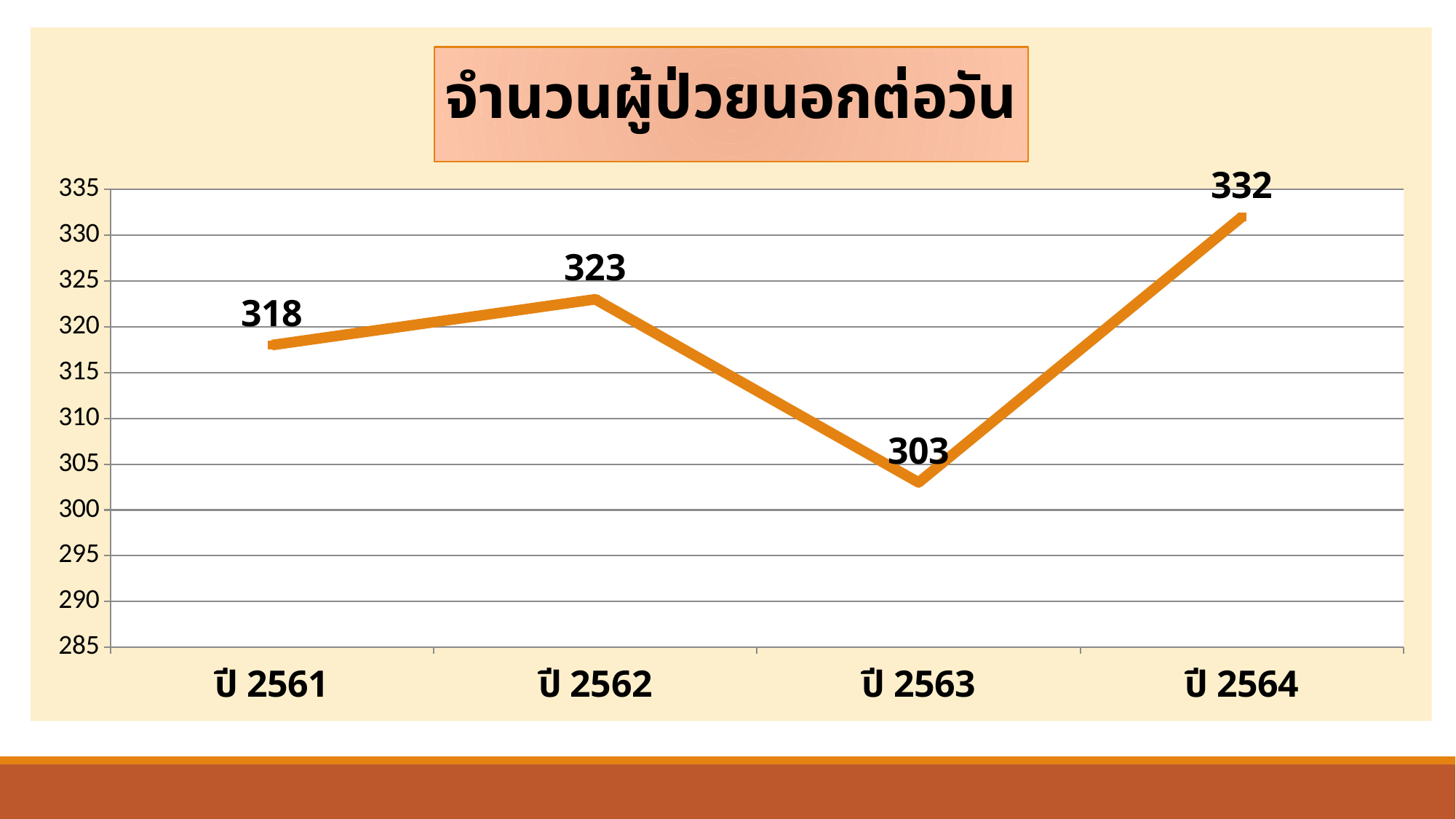
Which is larger, the value for ปี 2562 or the value for ปี 2563? ปี 2562 What is the value for ปี 2561? 318 Which year has the highest value? ปี 2564 What is the difference between the values for ปี 2564 and ปี 2563? 29 What is the difference between the values for ปี 2562 and ปี 2561? 5 What is the title of the chart? จำนวนผู้ป่วยนอกต่อวัน How many years are plotted on the chart? 4 What is the value for ปี 2563? 303 Is the value for ปี 2563 greater or less than 305? less What is the value for ปี 2564? 332 What kind of chart is shown on the slide? line chart Which year has the lowest value? ปี 2563